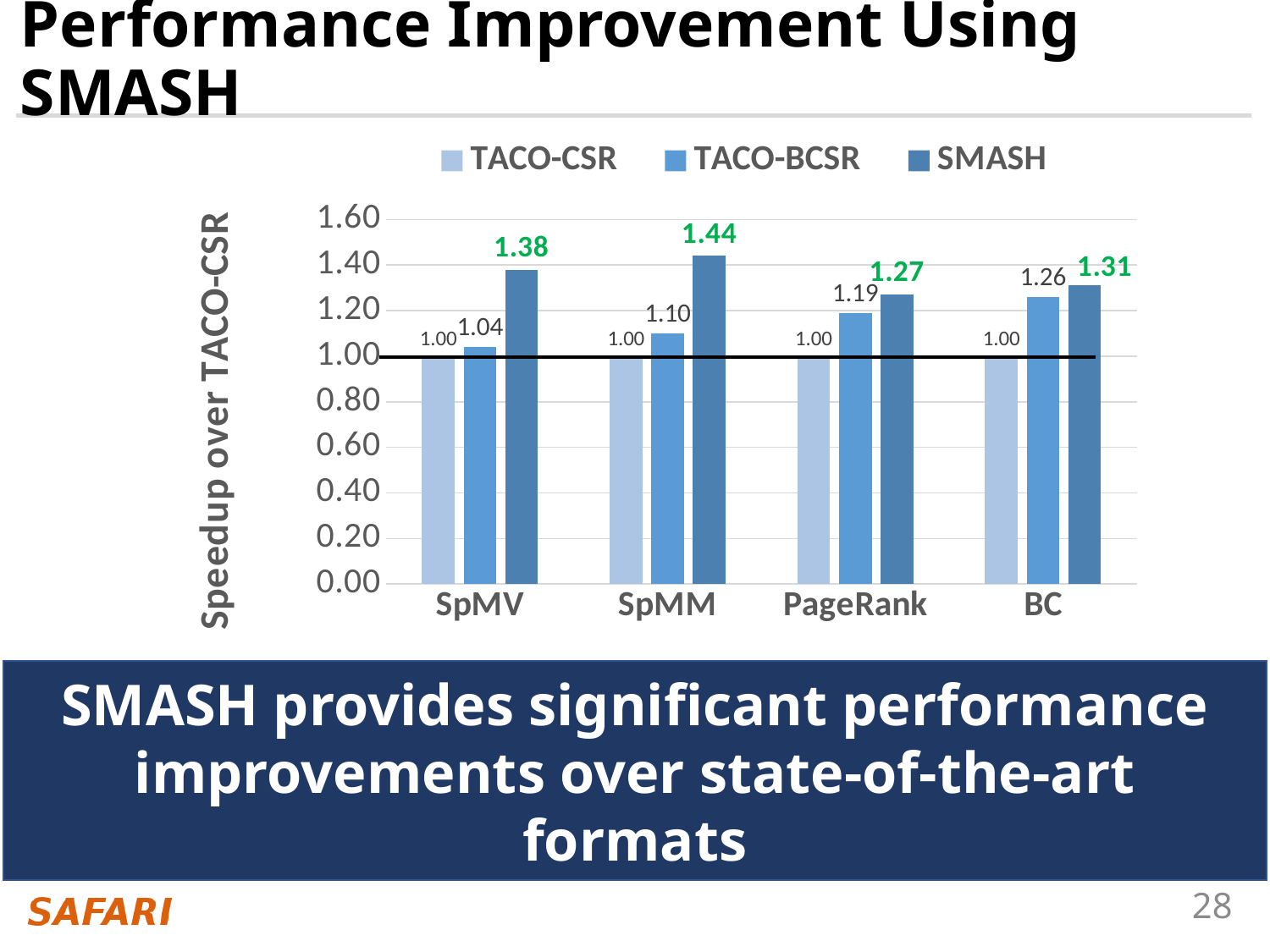
What is the SMASH speedup for BC? 1.31 How many workloads are shown on the x axis? 4 Which is larger for BC: the TACO-BCSR speedup or the SMASH speedup? SMASH What is the difference between the SMASH and TACO-BCSR speedups for SpMV? 0.34 What is the label of the y axis? Speedup over TACO-CSR What is the SMASH speedup for SpMM? 1.44 What is the TACO-BCSR speedup for PageRank? 1.19 What kind of chart is shown on the slide? bar chart For which workload is the SMASH speedup lowest? PageRank How many series does the legend list? 3 For which workload is the SMASH speedup highest? SpMM Is the SMASH speedup for SpMV greater or less than 1.20? greater